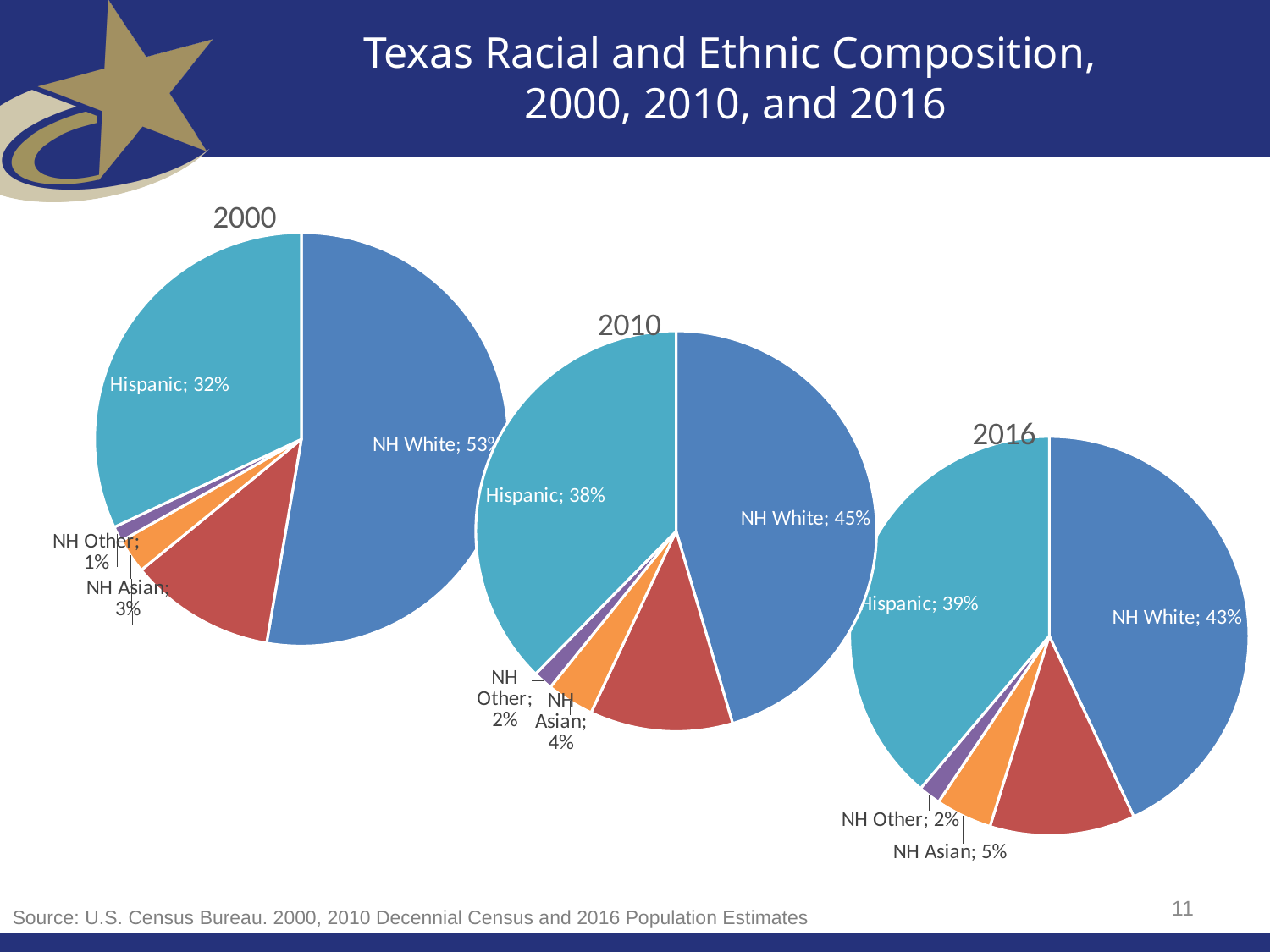
In the 2016 pie chart, which labeled category has the largest share? NH White How does the NH White share change across the 2000, 2010, and 2016 pie charts? It falls In the 2010 pie chart, what share is labeled for NH Asian? 4% In the 2016 pie chart, which is larger, the Hispanic share or the NH White share? NH White What is the title of the slide containing the three pie charts? Texas Racial and Ethnic Composition, 2000, 2010, and 2016 What kind of charts are shown on the slide? Pie charts In the 2000 pie chart, what share is labeled for Hispanic? 32% In the 2000 pie chart, what share is labeled for NH White? 53% In the 2016 pie chart, what share is labeled for NH Other? 2% In the 2000 pie chart, which labeled category has the smallest share? NH Other How many slices does the 2010 pie chart have? 5 In the 2010 pie chart, what is the difference between the NH White share and the Hispanic share? 7%